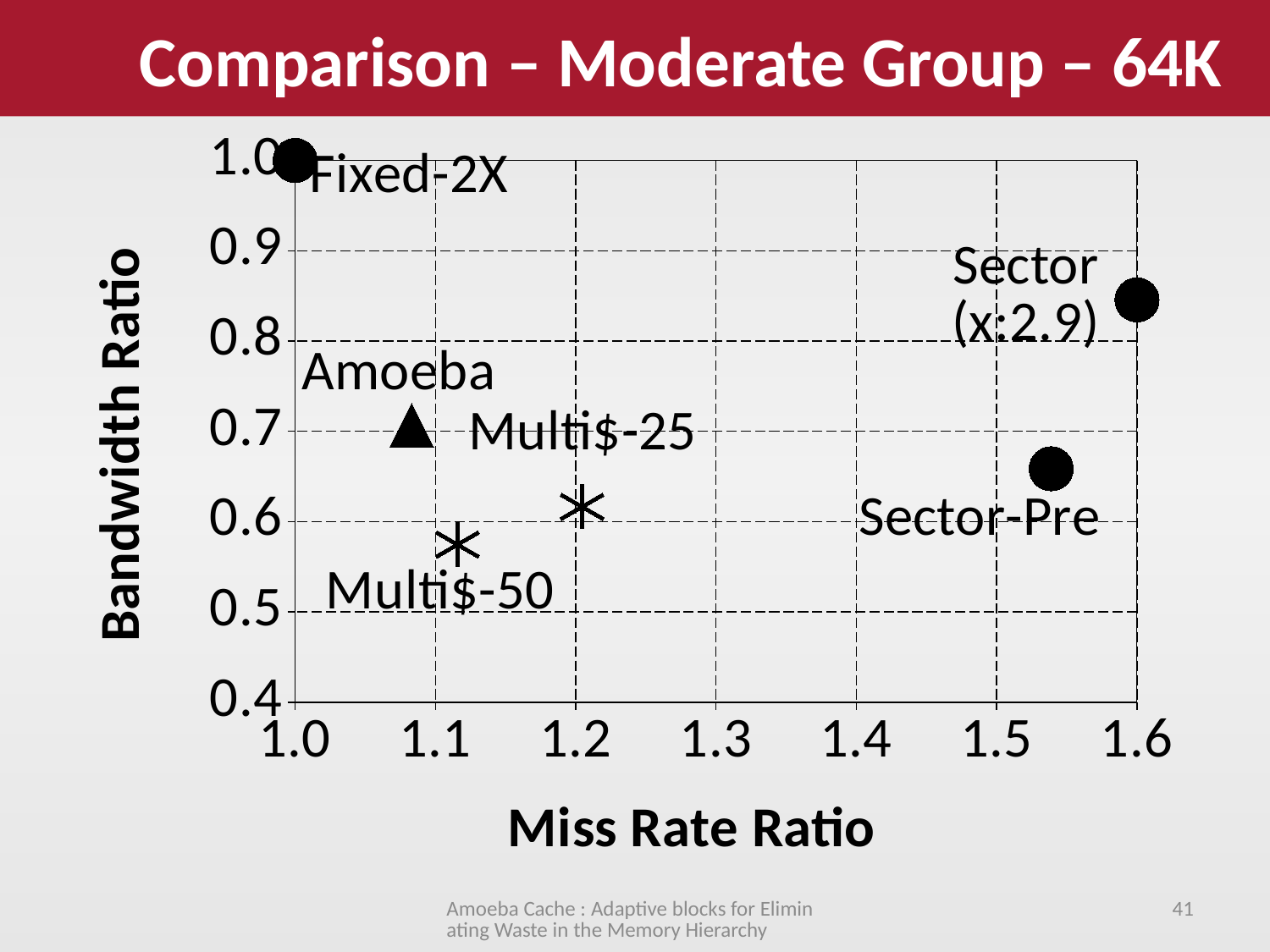
Which configuration has the lowest Bandwidth Ratio? Multi$-50 How many labeled data points are plotted on the chart? 6 Is the Bandwidth Ratio for Sector greater or less than 0.8? greater Which configuration has the highest Bandwidth Ratio? Fixed-2X What is the title of the x axis? Miss Rate Ratio What Miss Rate Ratio value is noted in the label for Sector? 2.9 Is the Bandwidth Ratio for Multi$-50 greater or less than 0.6? less What is the Bandwidth Ratio for Fixed-2X? 1.0 What kind of chart is shown on the slide? scatter chart Is the Miss Rate Ratio for Sector-Pre greater or less than 1.5? greater Which has the larger Bandwidth Ratio, Amoeba or Multi$-25? Amoeba